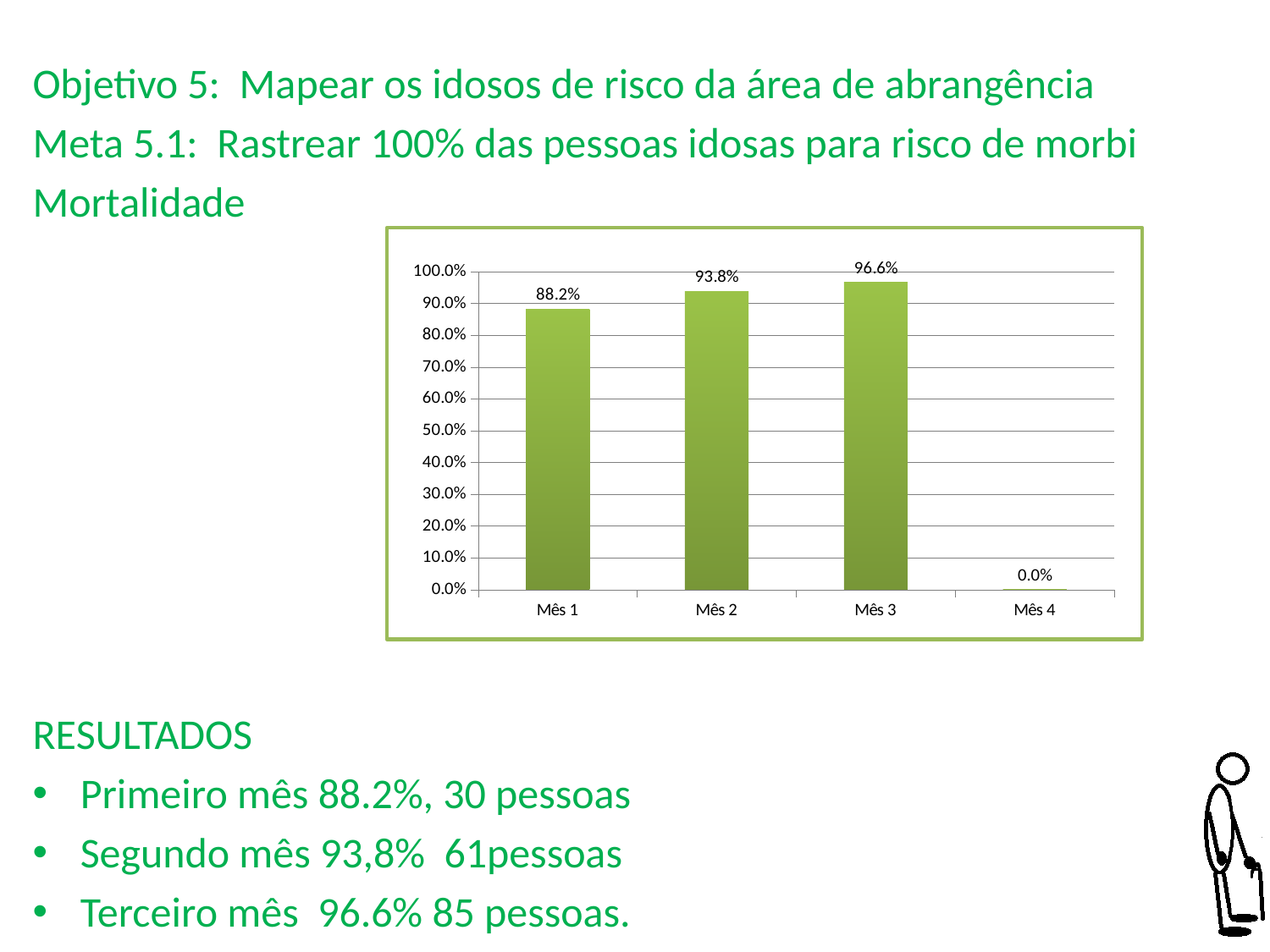
Which category has the highest value? Mês 3 What is the value for Mês 4? 0.0% What is the value for Mês 3? 96.6% What is the value for Mês 1? 88.2% What is the value for Mês 2? 93.8% Which is larger, the value for Mês 2 or the value for Mês 3? Mês 3 What is the difference between the values for Mês 3 and Mês 1? 8.4% What is the difference between the values for Mês 2 and Mês 1? 5.6% Do the values rise or fall from Mês 1 to Mês 3? Rise Which category has the lowest value? Mês 4 How many categories are shown on the x axis? 4 What kind of chart is shown on the slide? Bar chart